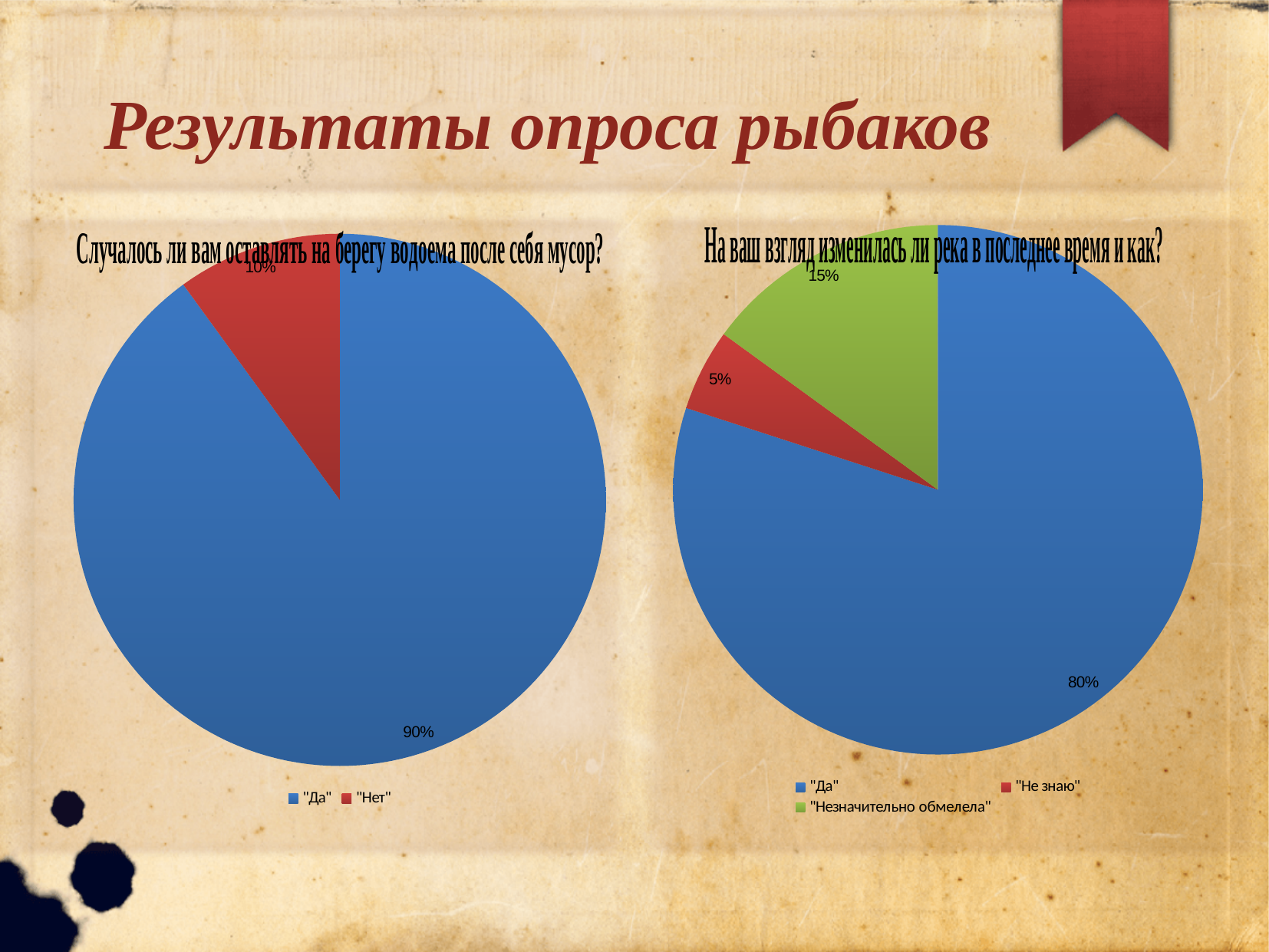
In the right chart ("На ваш взгляд изменилась ли река в последнее время и как?"), which answer has the smallest slice? "Не знаю" In the right chart ("На ваш взгляд изменилась ли река в последнее время и как?"), what colour is the "Незначительно обмелела" slice? Green In the left chart ("Случалось ли вам оставлять на берегу водоема после себя мусор?"), what share of respondents answered "Нет"? 10% In the right chart ("На ваш взгляд изменилась ли река в последнее время и как?"), which is larger: "Незначительно обмелела" or "Не знаю"? "Незначительно обмелела" What type of chart is used for the left chart ("Случалось ли вам оставлять на берегу водоема после себя мусор?")? Pie chart In the right chart ("На ваш взгляд изменилась ли река в последнее время и как?"), what share of respondents answered "Не знаю"? 5% In the left chart ("Случалось ли вам оставлять на берегу водоема после себя мусор?"), what share of respondents answered "Да"? 90% How many slices does the right chart ("На ваш взгляд изменилась ли река в последнее время и как?") have? 3 In the right chart ("На ваш взгляд изменилась ли река в последнее время и как?"), what share of respondents answered "Да"? 80% In the left chart ("Случалось ли вам оставлять на берегу водоема после себя мусор?"), which answer has the largest slice? "Да" In the left chart ("Случалось ли вам оставлять на берегу водоема после себя мусор?"), what is the difference in percentage points between "Да" and "Нет"? 80 percentage points In the right chart ("На ваш взгляд изменилась ли река в последнее время и как?"), what share of respondents answered "Незначительно обмелела"? 15%